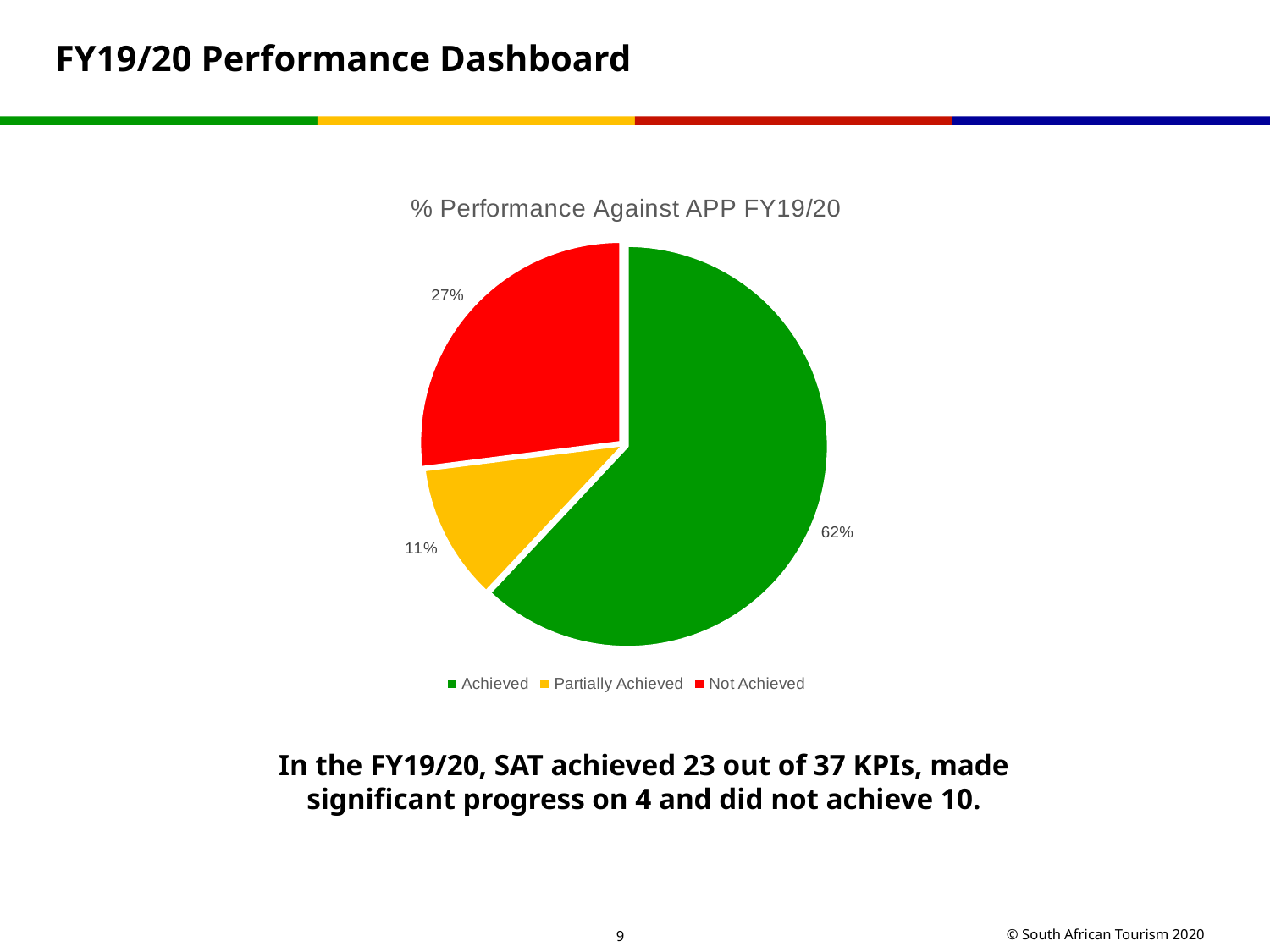
How many entries does the legend list? 3 Which slice is larger, Not Achieved or Partially Achieved? Not Achieved Which category has the largest share of the pie? Achieved What is the title of the chart? % Performance Against APP FY19/20 What is the difference in percentage points between the Achieved and Not Achieved slices? 35 What percentage of the pie is labelled Partially Achieved? 11% Which category has the smallest share of the pie? Partially Achieved How many slices does the pie chart have? 3 What percentage of the pie is labelled Achieved? 62% What percentage of the pie is labelled Not Achieved? 27% What type of chart is shown on the slide? pie chart What colour is the Not Achieved slice? red